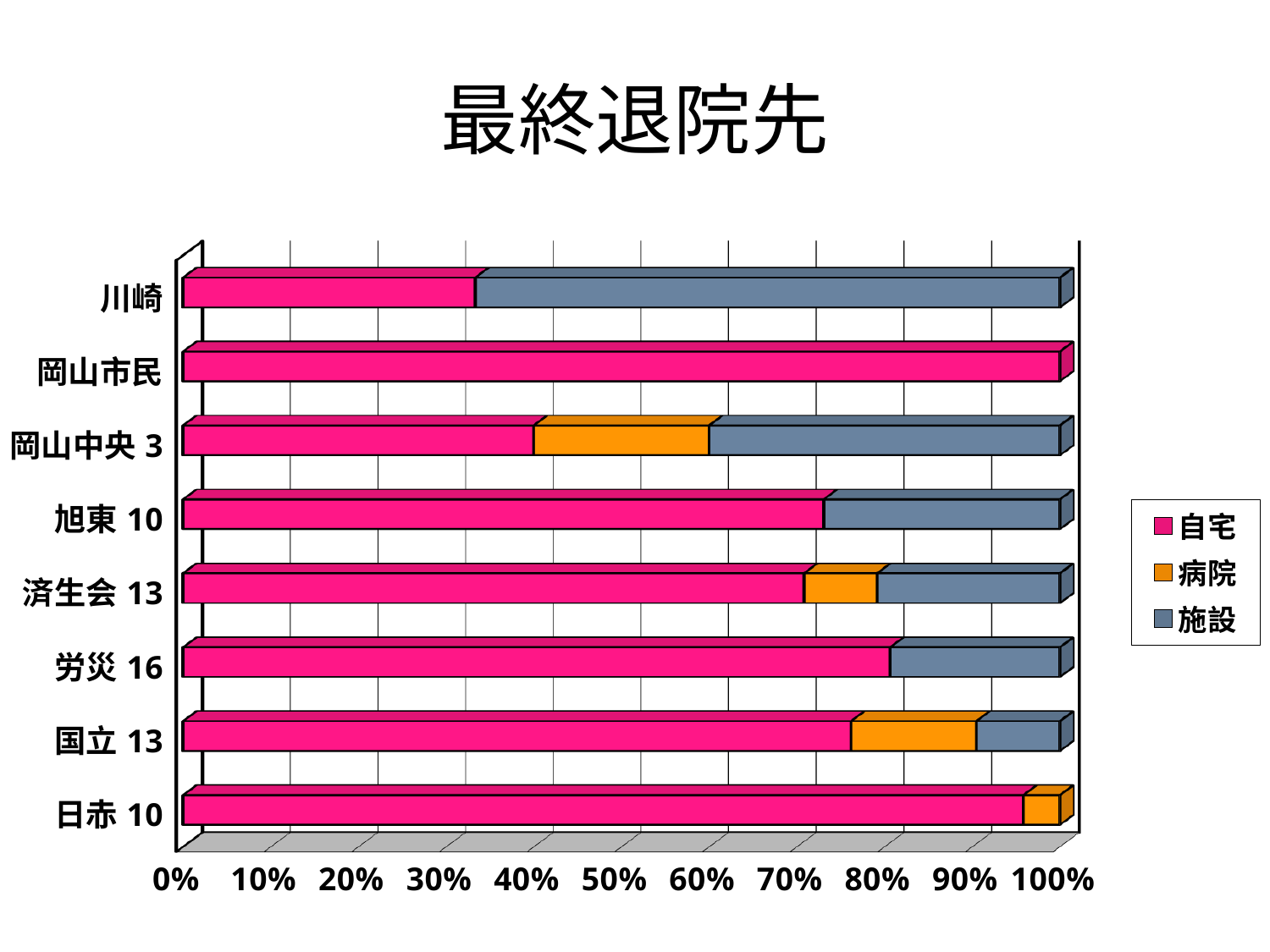
How many series does the legend list? 3 Which legend entry is shown in orange? 病院 Is the 自宅 share for 川崎 greater or less than 40%? less Which has the larger 自宅 share, 川崎 or 旭東 10? 旭東 10 What kind of chart is shown on the slide? bar chart Which category has the largest 施設 share? 川崎 Is the 自宅 share for 日赤 10 greater or less than 90%? greater What is the title of the chart? 最終退院先 Which category has the lowest 自宅 share? 川崎 Which category has the highest 自宅 share? 岡山市民 What is the 自宅 share for 岡山市民? 100% How many hospital categories are plotted on the chart? 8